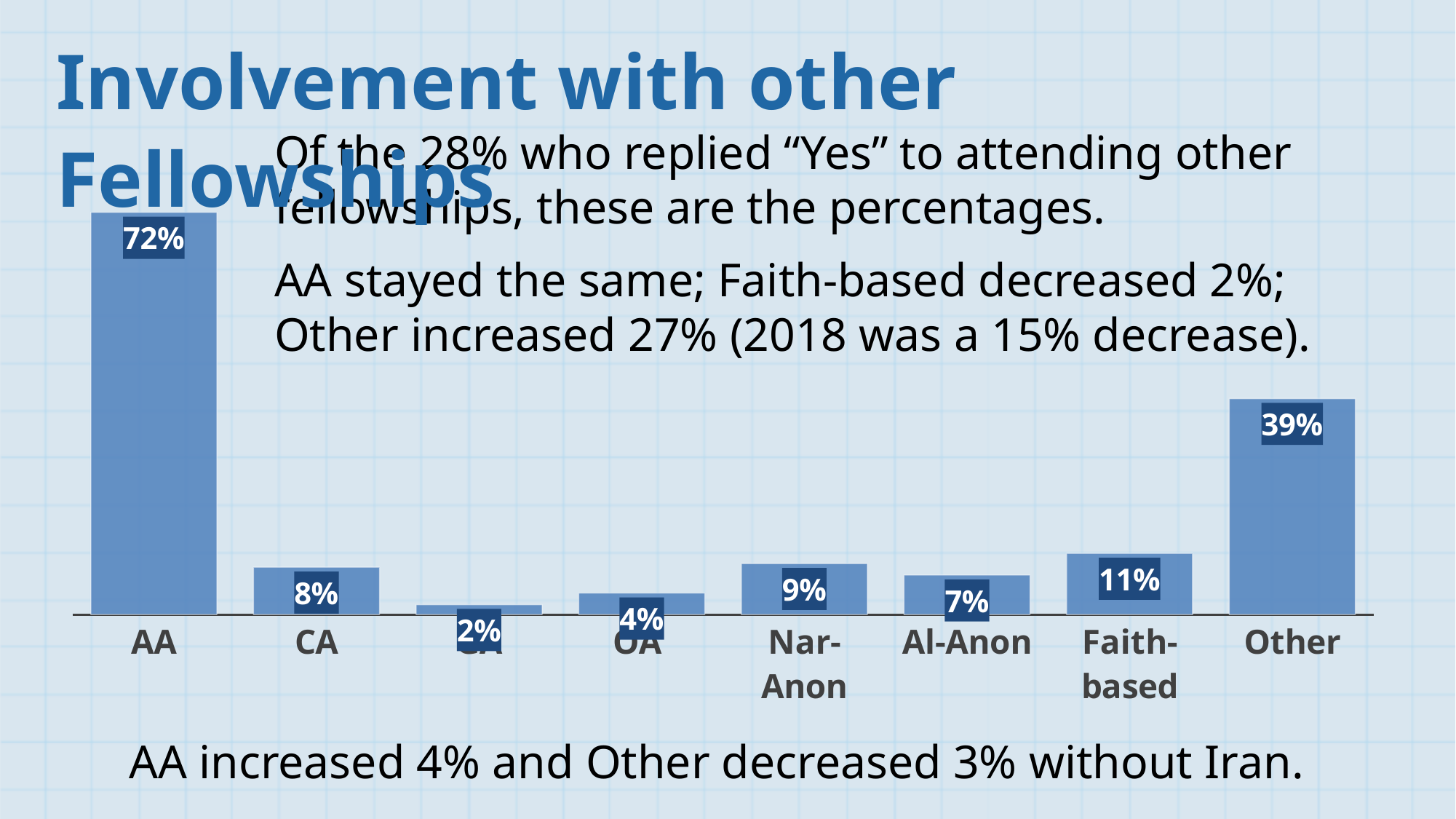
What is the difference between the values for Faith-based and CA? 3% What is the value for Other? 39% What is the value for Al-Anon? 7% How many categories are shown in the chart? 8 What kind of chart is shown on the slide? Bar chart What is the value for Faith-based? 11% Which is larger, the value for Nar-Anon or the value for OA? Nar-Anon What is the difference between the values for AA and Other? 33% What is the title of the slide containing the chart? Involvement with other Fellowships Which category has the highest value? AA What is the value for AA? 72% What is the value for Nar-Anon? 9%